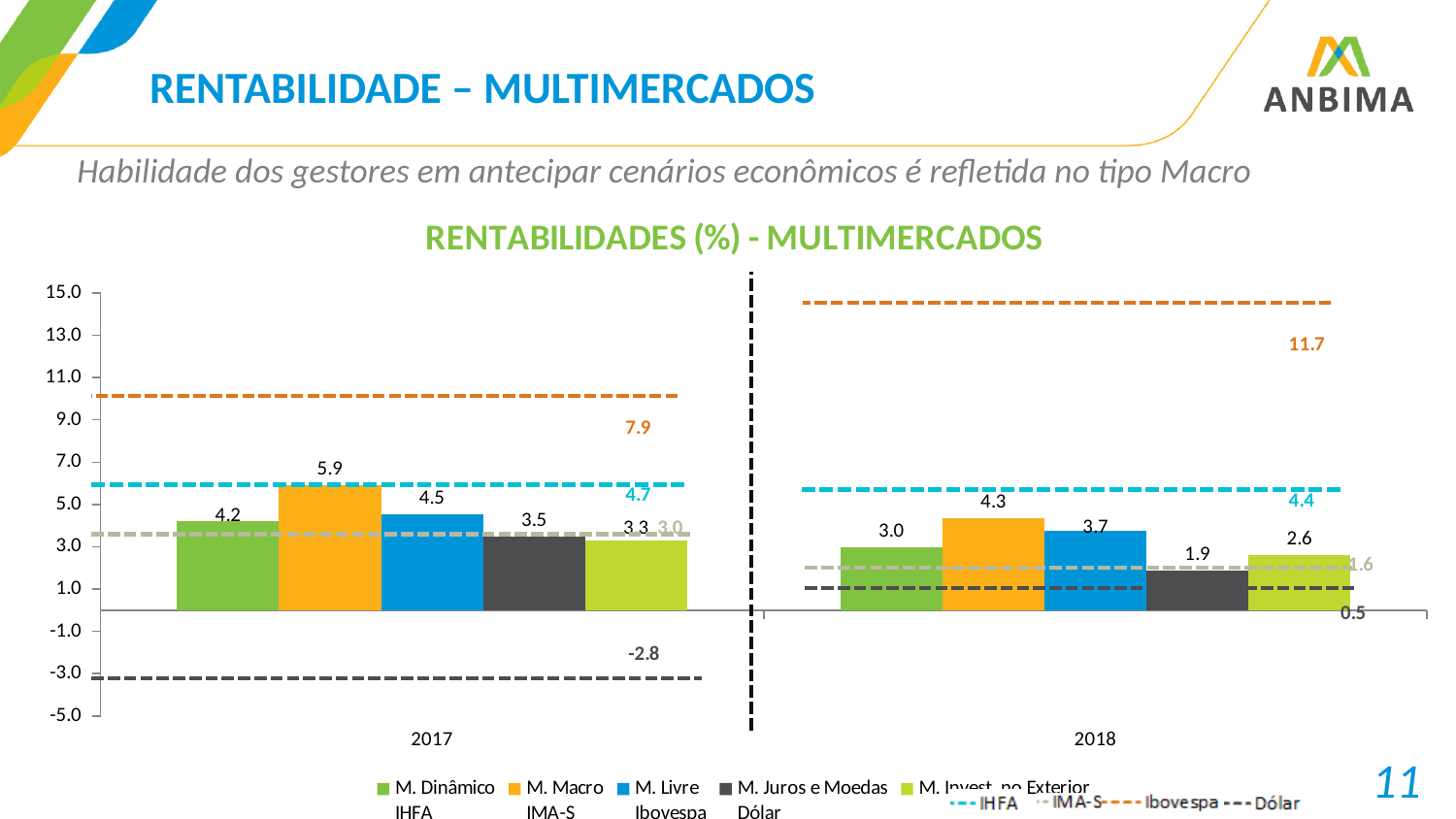
Is the M. Livre value larger in 2017 or in 2018? 2017 What is the difference between the M. Macro value in 2017 and in 2018? 1.6 Which bar series has the lowest value in 2018? M. Juros e Moedas Does the value for M. Dinâmico rise or fall from 2017 to 2018? fall How many bar series does the legend list? 5 What value is labelled for the Ibovespa line in 2018? 11.7 What kind of chart is shown on the slide? combination bar and line chart Is the value for M. Macro in 2017 greater or less than 5.0? greater Which bar series has the highest value in 2017? M. Macro What is the value for M. Macro in 2017? 5.9 What value is labelled for the Dólar line in 2017? -2.8 What is the value for M. Juros e Moedas in 2018? 1.9